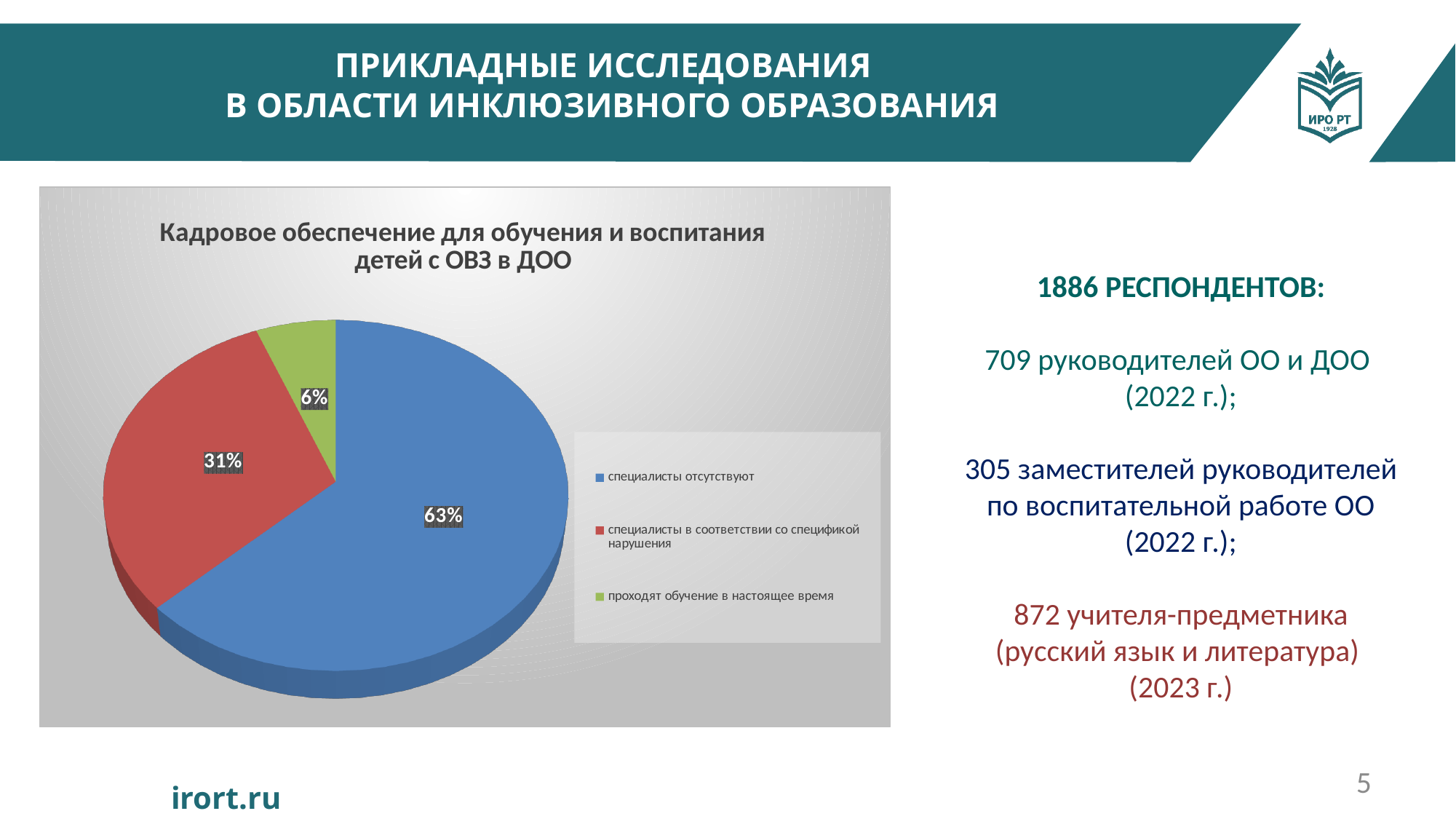
How many slices does the pie chart have? 3 What type of chart is shown on the slide? Pie chart Which is larger: the slice for "специалисты в соответствии со спецификой нарушения" or the slice for "проходят обучение в настоящее время"? специалисты в соответствии со спецификой нарушения Which category has the largest slice of the pie? специалисты отсутствуют What is the difference in percentage points between "специалисты отсутствуют" and "специалисты в соответствии со спецификой нарушения"? 32 percentage points How many entries does the legend list? 3 What colour is the slice for "проходят обучение в настоящее время"? Green What is the title of the chart? Кадровое обеспечение для обучения и воспитания детей с ОВЗ в ДОО What share of the pie is labelled "специалисты в соответствии со спецификой нарушения"? 31% What share of the pie is labelled "проходят обучение в настоящее время"? 6% What share of the pie is labelled "специалисты отсутствуют"? 63% Which category has the smallest slice of the pie? проходят обучение в настоящее время